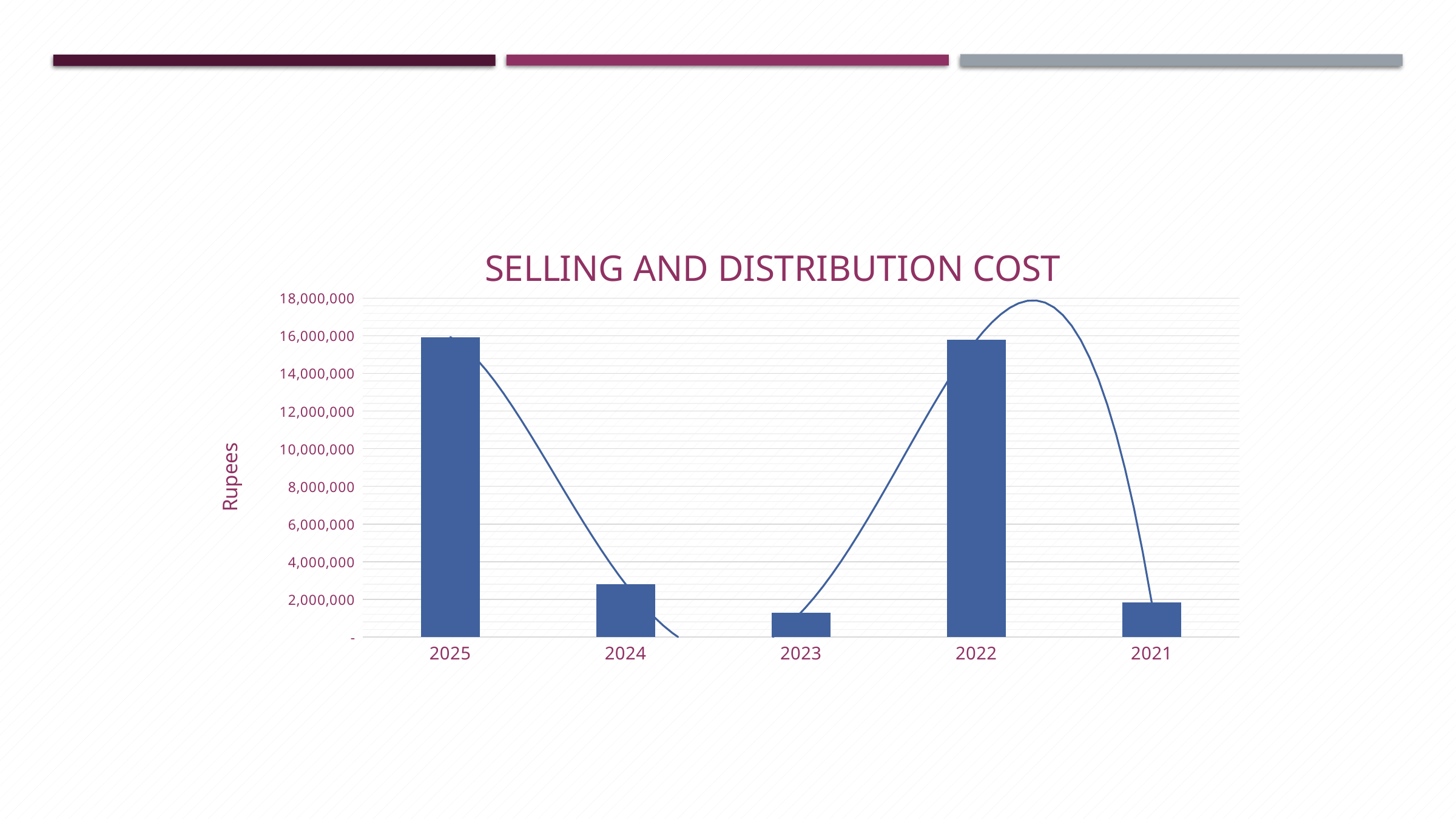
Is the value for 2022 greater or less than 14,000,000? greater What is the title of the chart? SELLING AND DISTRIBUTION COST What kind of chart is shown on the slide? bar chart Which is larger, the value for 2022 or the value for 2023? 2022 How many years are shown on the x axis of the chart? 5 Is the value for 2023 greater or less than 2,000,000? less Which is larger, the value for 2024 or the value for 2021? 2024 Is the value for 2021 greater or less than 4,000,000? less Which year has the lowest selling and distribution cost? 2023 What is the label on the vertical axis of the chart? Rupees